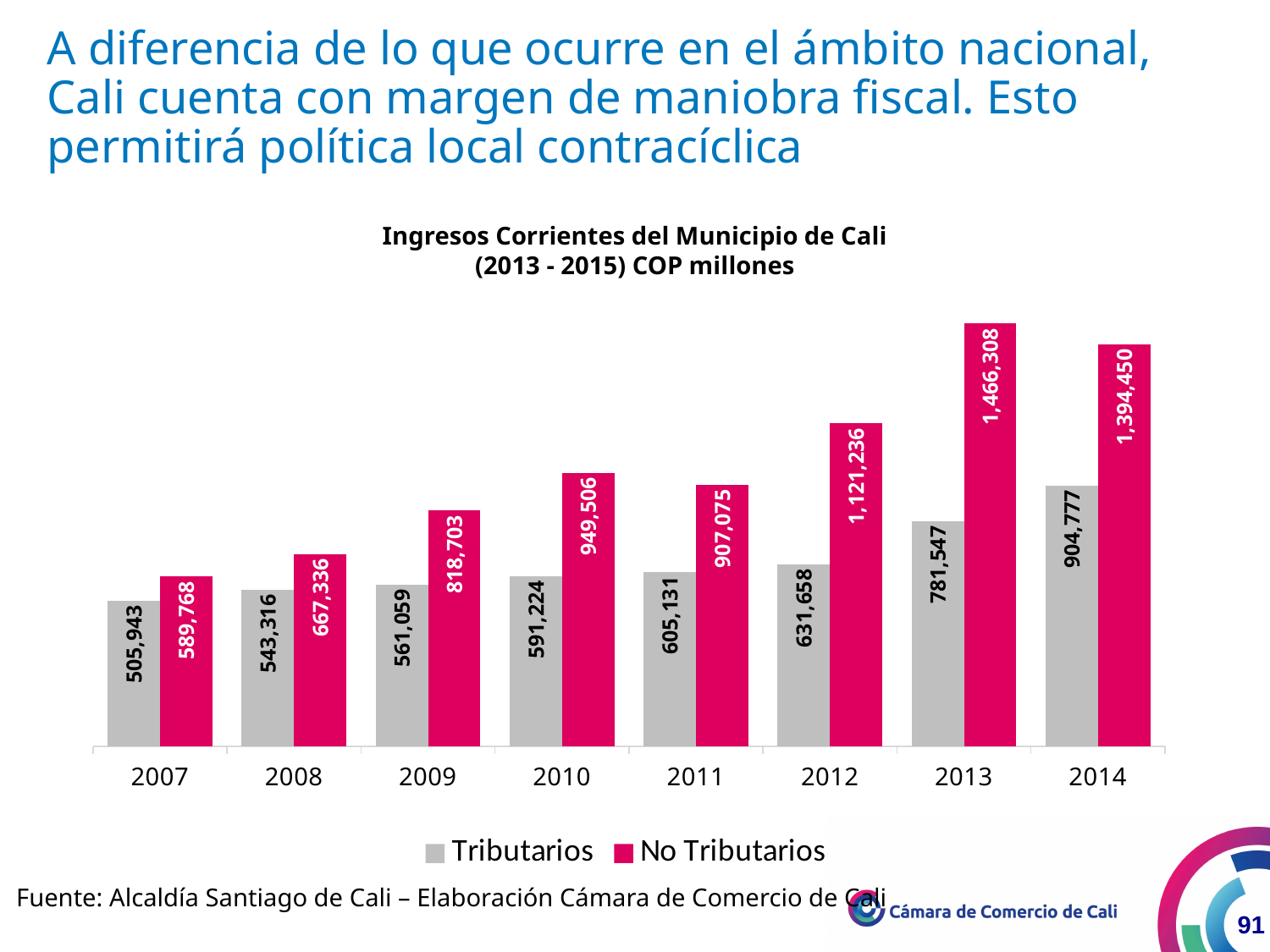
Do the Tributarios values rise or fall from 2007 to 2014? rise How many series does the legend list? 2 What is the value for Tributarios in 2007? 505,943 What is the value for Tributarios in 2014? 904,777 How many years are shown on the x axis? 8 By how much did Tributarios increase from 2012 to 2013? 149,889 What is the value for No Tributarios in 2010? 949,506 What is the difference between No Tributarios and Tributarios in 2014? 489,673 In which year is the Tributarios value lowest? 2007 What is the value for No Tributarios in 2013? 1,466,308 In which year is the No Tributarios value highest? 2013 Which is larger, No Tributarios in 2010 or No Tributarios in 2011? No Tributarios in 2010